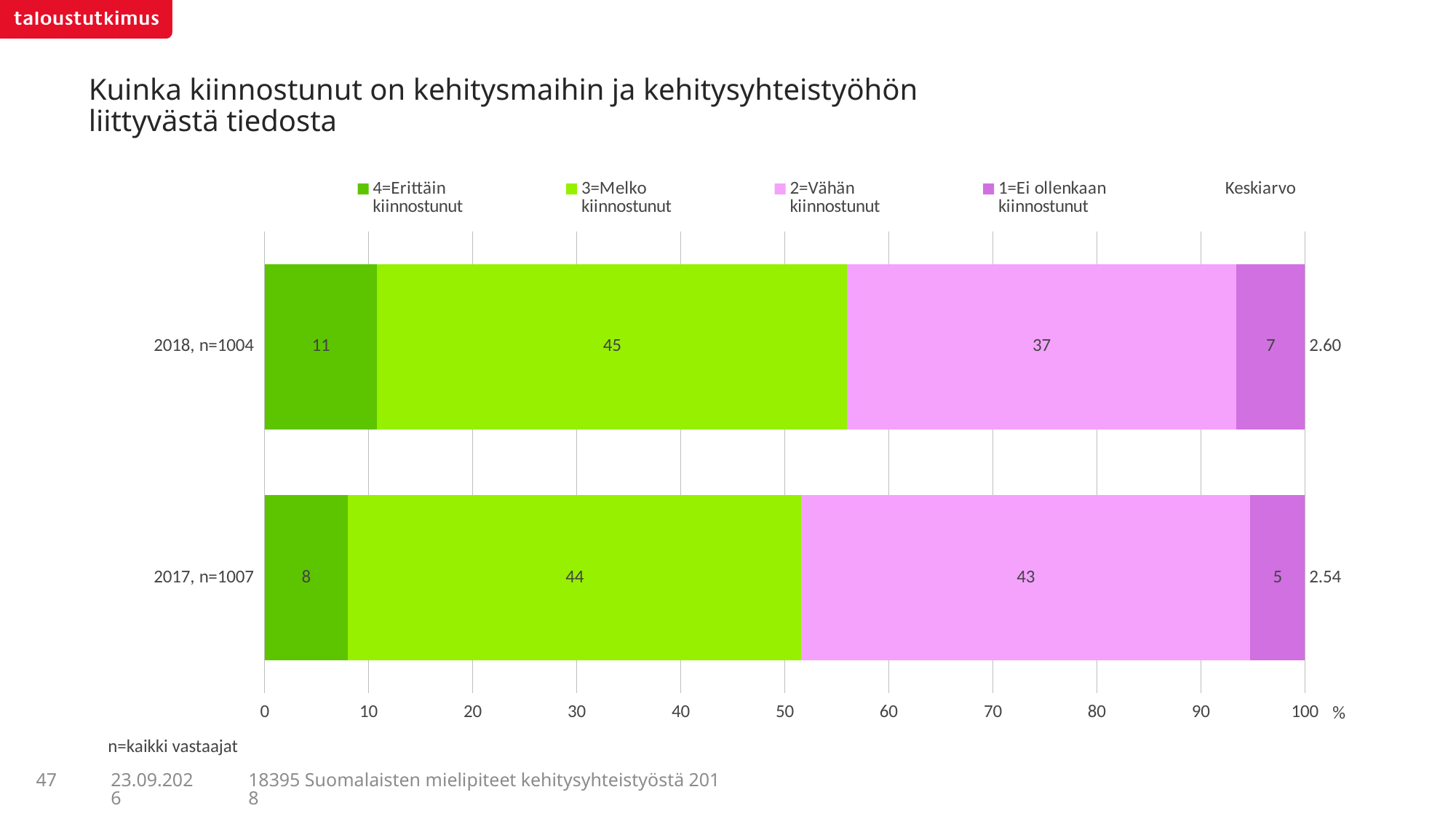
How many entries does the legend list? 5 What is the value for "2=Vähän kiinnostunut" in the 2017, n=1007 bar? 43 How many bars (categories) does the chart show? 2 What is the value for "4=Erittäin kiinnostunut" in the 2017, n=1007 bar? 8 Which segment is the largest in the 2017, n=1007 bar? 3=Melko kiinnostunut What is the difference between the "4=Erittäin kiinnostunut" values for 2018 and 2017? 3 What is the difference between the "2=Vähän kiinnostunut" values for 2017 and 2018? 6 What kind of chart is shown on the slide? Stacked bar chart What is the value for "3=Melko kiinnostunut" in the 2018, n=1004 bar? 45 What is the Keskiarvo value shown for 2018, n=1004? 2.60 Which segment is the smallest in the 2018, n=1004 bar? 1=Ei ollenkaan kiinnostunut Which year has the higher value for "1=Ei ollenkaan kiinnostunut", 2018 or 2017? 2018